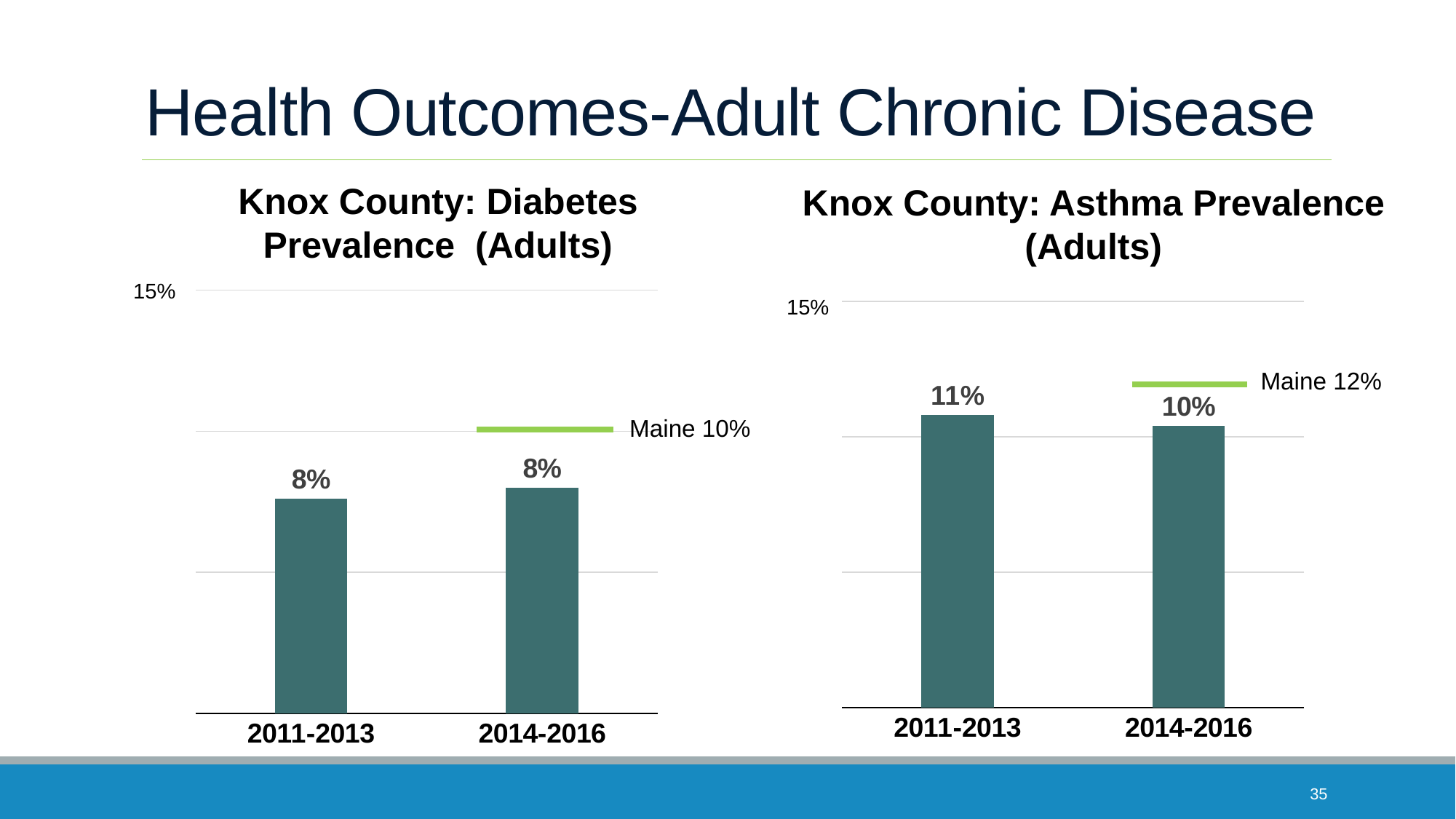
How many bars are in the Knox County: Asthma Prevalence (Adults) chart? 2 In the Knox County: Diabetes Prevalence (Adults) chart, what Maine value is marked by the green line? 10% In the Knox County: Asthma Prevalence (Adults) chart, what is the value for 2011-2013? 11% In the Knox County: Diabetes Prevalence (Adults) chart, what is the value for 2014-2016? 8% In the Knox County: Asthma Prevalence (Adults) chart, which period has the higher value? 2011-2013 In the Knox County: Asthma Prevalence (Adults) chart, what Maine value is marked by the green line? 12% In the Knox County: Asthma Prevalence (Adults) chart, what is the difference between the 2011-2013 and 2014-2016 values? 1% In the Knox County: Diabetes Prevalence (Adults) chart, what is the value for 2011-2013? 8% In the Knox County: Asthma Prevalence (Adults) chart, do the values rise or fall from 2011-2013 to 2014-2016? fall In the Knox County: Diabetes Prevalence (Adults) chart, is the 2014-2016 value greater or less than the Maine 10% line? less What kind of chart is the Knox County: Diabetes Prevalence (Adults) chart? bar chart In the Knox County: Asthma Prevalence (Adults) chart, what is the value for 2014-2016? 10%